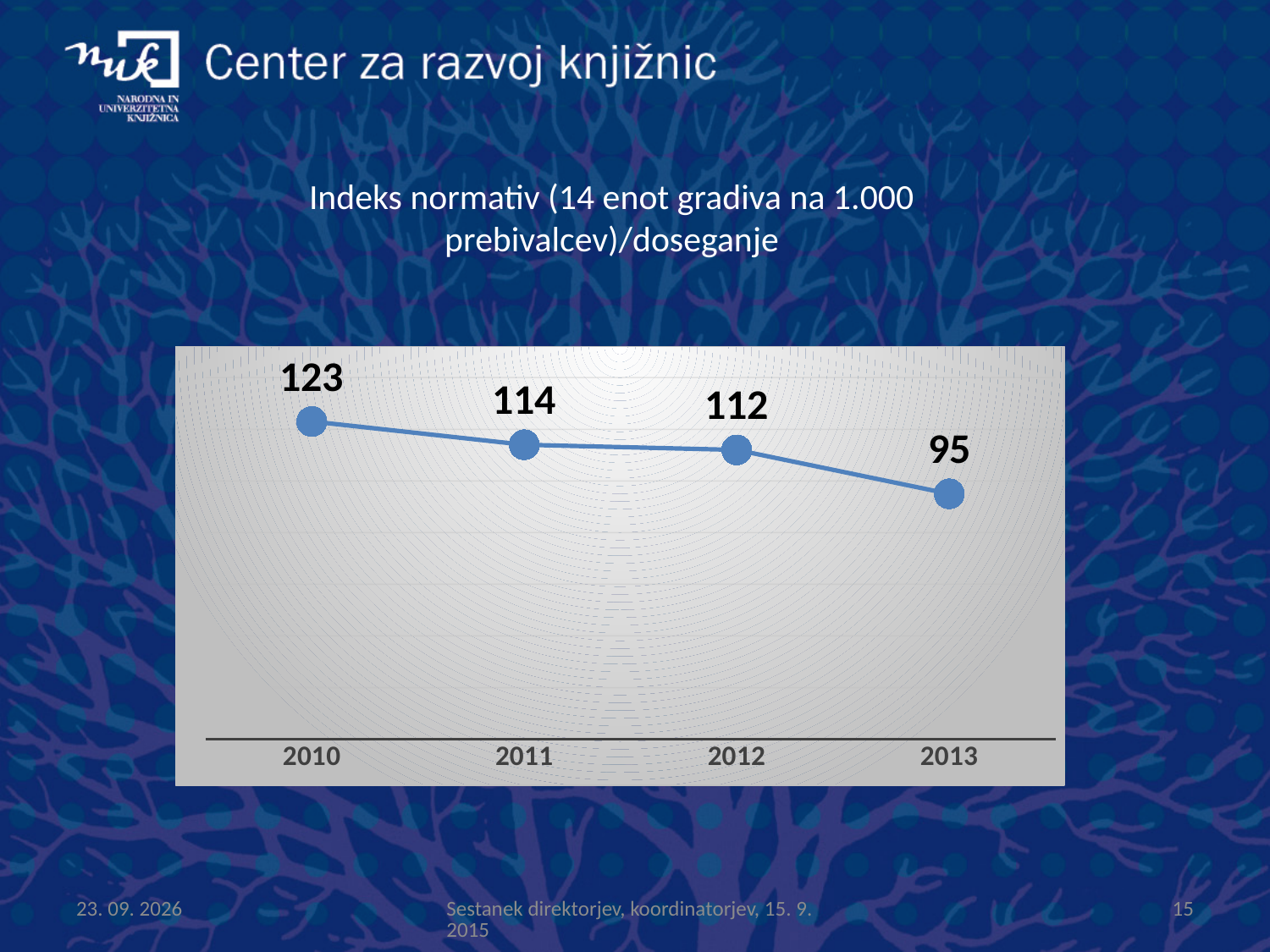
What is the difference between the values for 2011 and 2012? 2 Which year has the highest value? 2010 Which year has the lowest value? 2013 Do the values rise or fall from 2010 to 2013? fall What is the difference between the values for 2010 and 2013? 28 Which is larger, the value for 2010 or the value for 2011? 2010 What kind of chart is shown on the slide? line chart What is the value for 2011? 114 How many years are plotted on the chart? 4 What is the value for 2010? 123 What is the value for 2012? 112 What is the value for 2013? 95